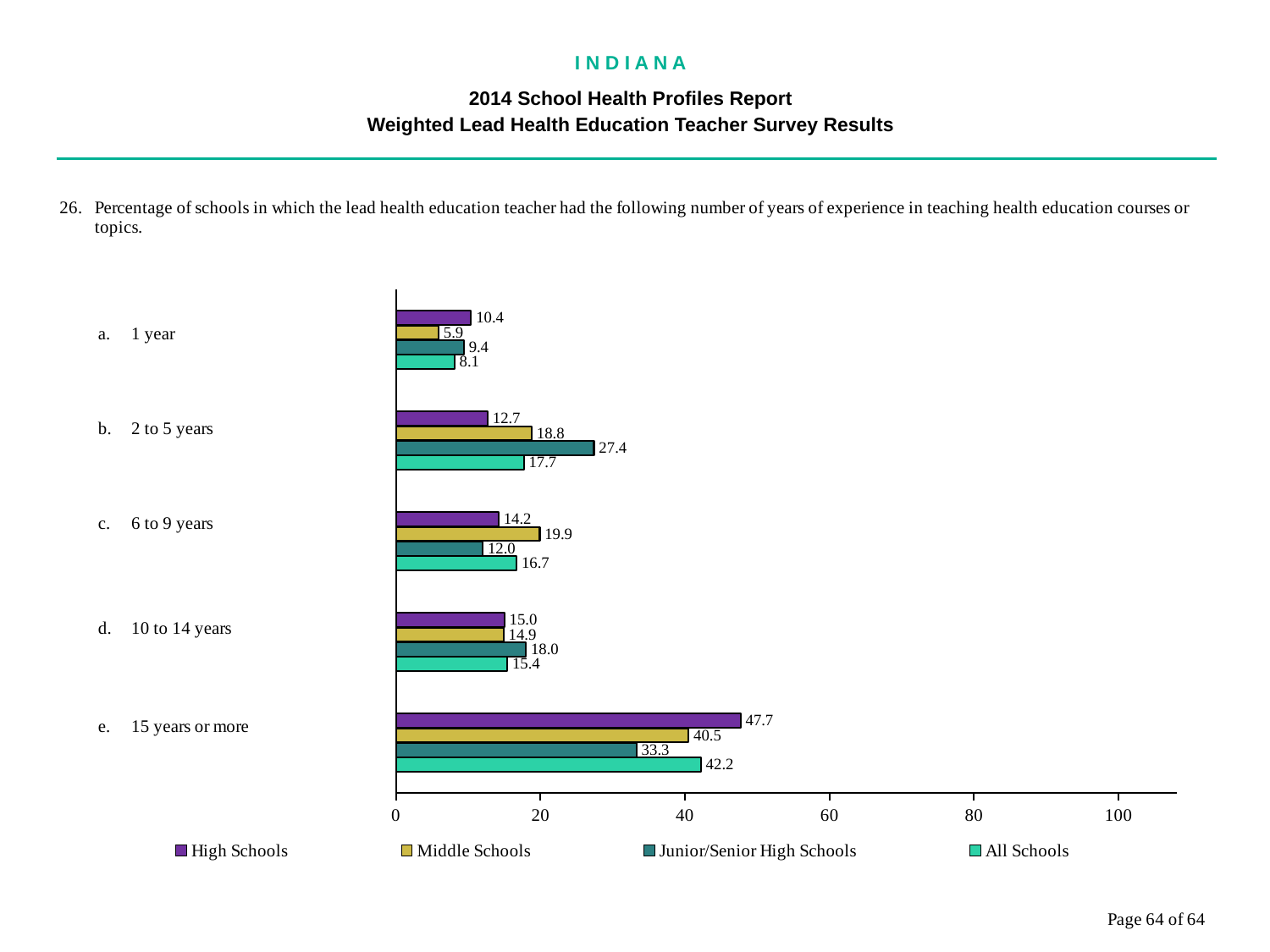
What kind of chart is shown on the slide? Bar chart What is the value for Junior/Senior High Schools in the 2 to 5 years category? 27.4 What is the All Schools value for the 6 to 9 years category? 16.7 What percentage of High Schools had a lead health education teacher with 15 years or more of experience? 47.7 In the 6 to 9 years category, which is larger: the Middle Schools value or the Junior/Senior High Schools value? Middle Schools Which series is shown in purple in the legend? High Schools How many series does the legend list? 4 Which experience category has the lowest value for All Schools? 1 year How many experience categories are shown on the chart? 5 Which experience category has the highest value for Middle Schools? 15 years or more Is the All Schools value for 15 years or more greater or less than 40? greater What is the difference between the High Schools and Junior/Senior High Schools values for 15 years or more? 14.4